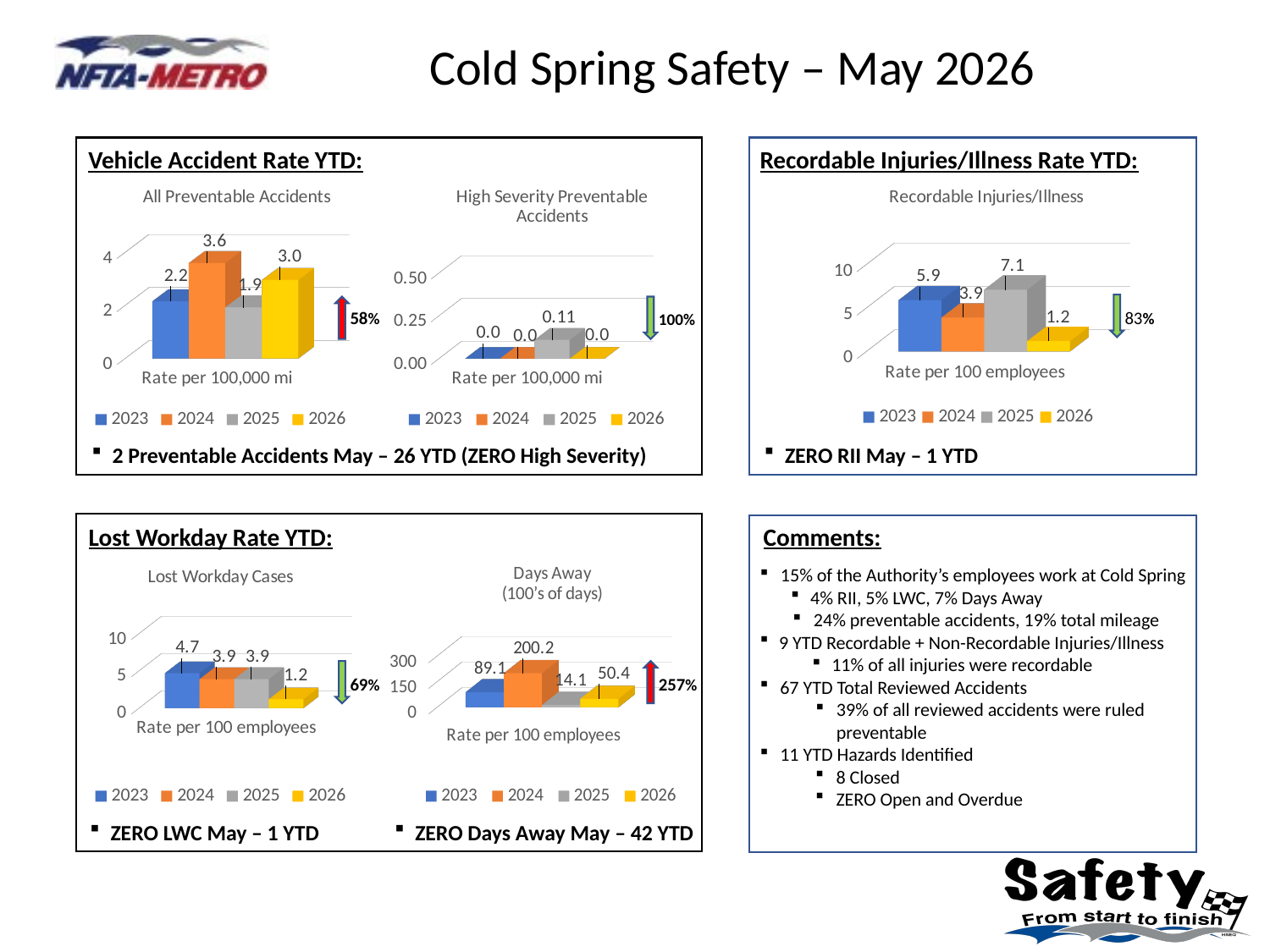
In the "Recordable Injuries/Illness" chart, which year has the highest value? 2025 What kind of chart is the "Days Away" chart? bar chart In the "Recordable Injuries/Illness" chart, is the value for 2023 larger or smaller than the value for 2024? larger In the "Lost Workday Cases" chart, how many series does the legend list? 4 In the "All Preventable Accidents" chart, what is the difference between the 2024 and 2025 values? 1.7 In the "High Severity Preventable Accidents" chart, what is the value for 2025? 0.11 In the "All Preventable Accidents" chart, which year has the lowest value? 2025 In the "Lost Workday Cases" chart, what is the value for 2023? 4.7 In the "Days Away" chart, which year has the lowest value? 2025 In the "All Preventable Accidents" chart, what is the value for 2024? 3.6 In the "Recordable Injuries/Illness" chart, what is the value for 2026? 1.2 In the "Days Away" chart, what is the value for 2024? 200.2